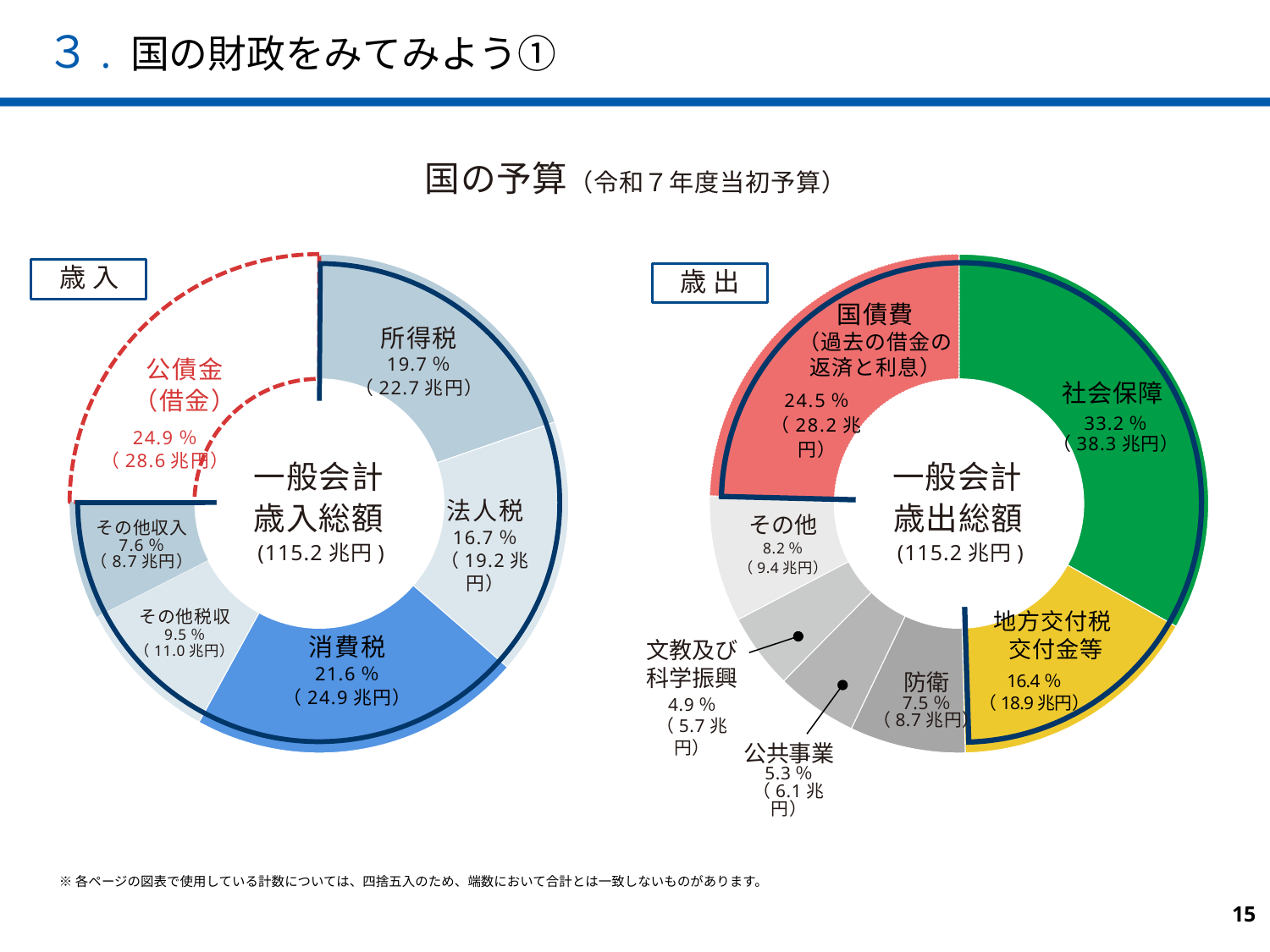
In the 歳入 chart, what is the difference in percentage points between 消費税 and 法人税? 4.9 In the 歳出 chart, which category has the smallest share? 文教及び科学振興 In the 歳出 chart, what is the difference in 兆円 between 社会保障 and 国債費? 10.1兆円 In the 歳入 chart, how many categories are shown? 6 In the 歳入 chart, what percentage share does 所得税 have? 19.7% What type of chart is used for the 歳出 data? Donut (pie) chart In the 歳入 chart, which category has the largest share? 公債金（借金） In the 歳入 chart, which category has the smallest share? その他収入 In the 歳出 chart, what percentage share does 国債費 have? 24.5% In the 歳入 chart, what is the amount shown for 消費税? 24.9兆円 In the 歳出 chart, what is the amount shown for 社会保障? 38.3兆円 In the 歳出 chart, which is larger, 防衛 or 公共事業? 防衛